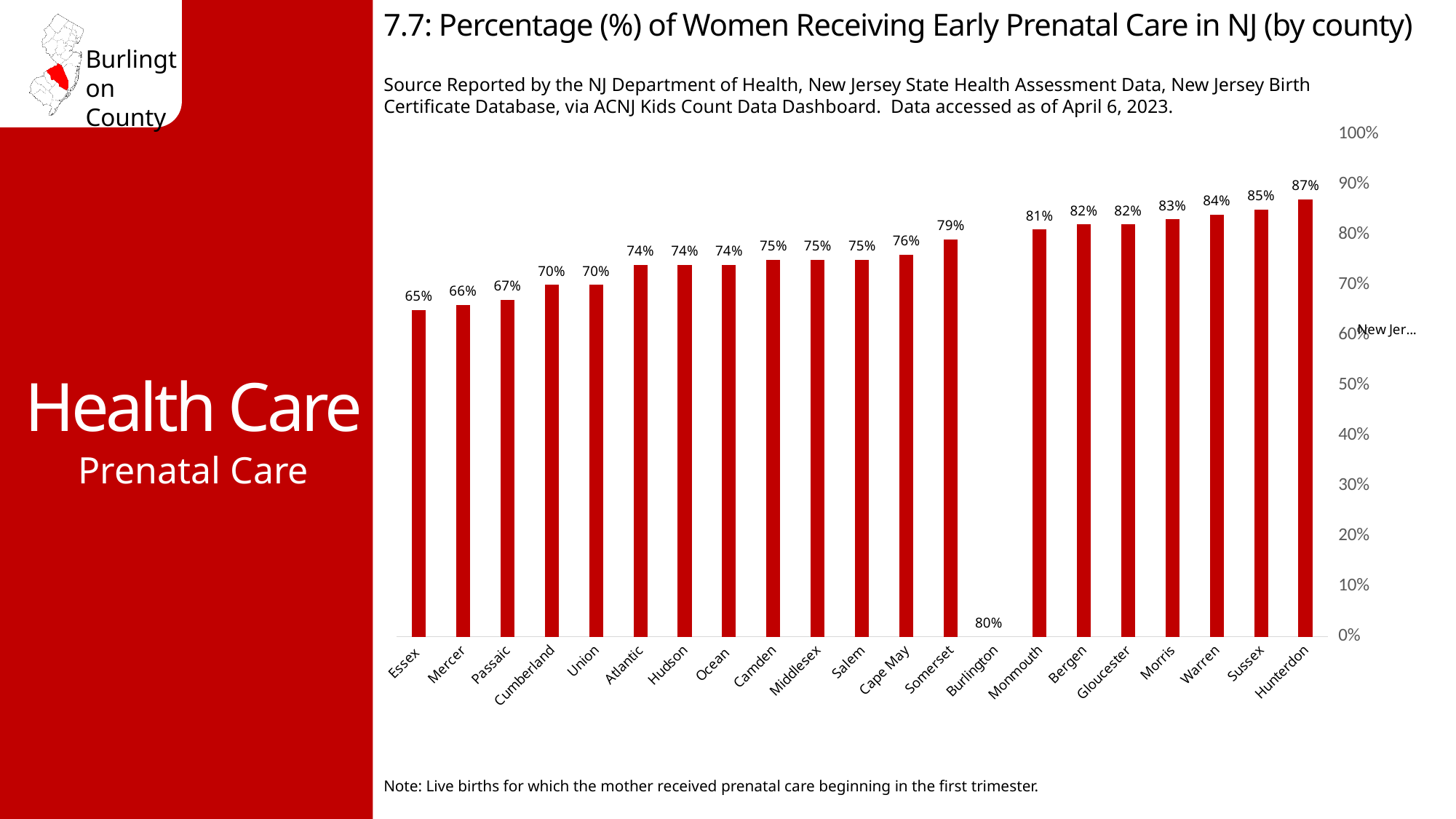
What is the difference between the values for Hunterdon and Essex? 22% What percentage is shown for Somerset County? 79% What percentage of women received early prenatal care in Hunterdon County? 87% Which county has the lowest percentage of women receiving early prenatal care? Essex How many counties are shown on the x axis of the chart? 21 What value is labeled for Burlington County? 80% Which county has the highest percentage of women receiving early prenatal care? Hunterdon Do the values generally rise or fall moving from left to right along the x axis? rise What is the value shown for Essex County? 65% Is the value for Mercer County greater or less than 70%? less Which county has a higher value, Monmouth or Cape May? Monmouth What kind of chart is used on this slide? bar chart